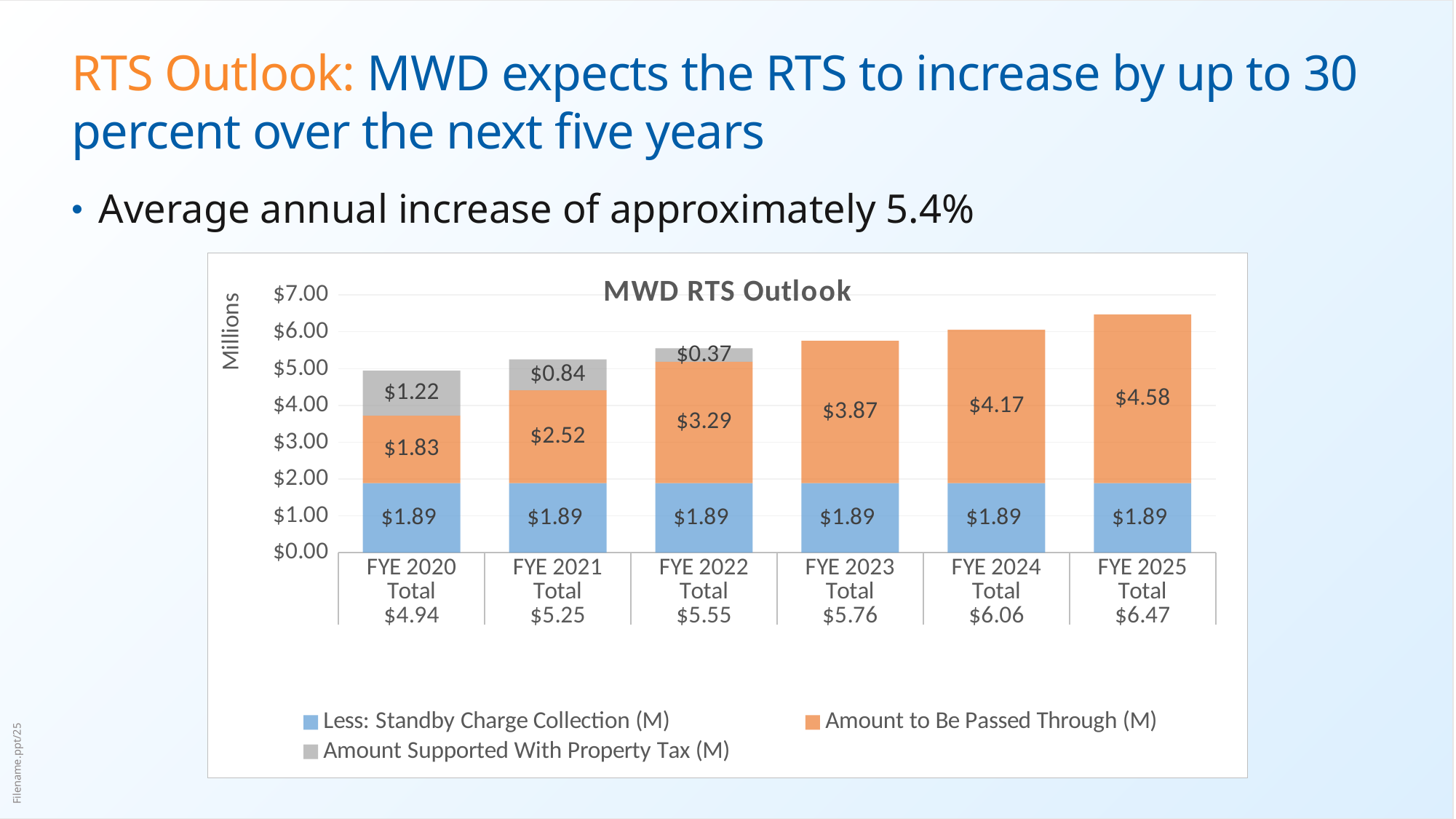
What is the value of Amount to Be Passed Through (M) for FYE 2022? $3.29 Do the bar totals rise or fall from FYE 2020 to FYE 2025? Rise How many series does the legend list? 3 Which fiscal year has the lowest total? FYE 2020 Which fiscal year has the highest Amount to Be Passed Through (M)? FYE 2025 What type of chart is shown on the slide? Stacked bar chart What is the total of the stacked bar for FYE 2023? $5.76 How many fiscal years are shown on the x axis? 6 What is the difference between the Amount to Be Passed Through (M) for FYE 2025 and FYE 2024? $0.41 What is the value of Amount Supported With Property Tax (M) for FYE 2020? $1.22 What is the value of Less: Standby Charge Collection (M) for FYE 2025? $1.89 What is the title of the chart? MWD RTS Outlook